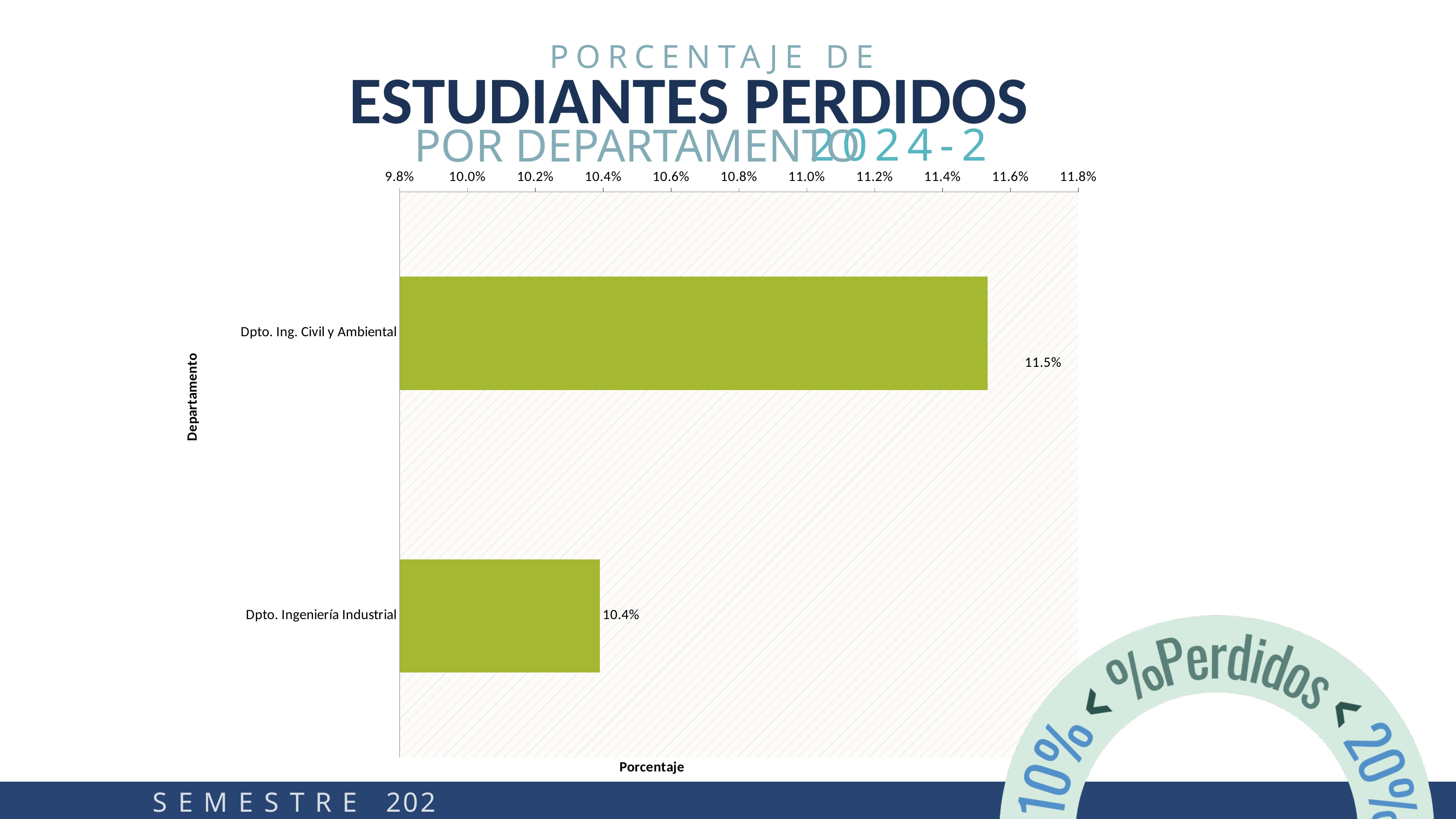
What kind of chart is shown on the slide? Bar chart What is the difference between the values for Dpto. Ing. Civil y Ambiental and Dpto. Ingeniería Industrial? 1.1% Is the value for Dpto. Ingeniería Industrial greater or less than 11.0%? less How many departments are shown in the chart? 2 What is the value for Dpto. Ing. Civil y Ambiental? 11.5% Is the value for Dpto. Ing. Civil y Ambiental greater or less than 11.0%? greater What is the value for Dpto. Ingeniería Industrial? 10.4% What is the label of the horizontal axis? Porcentaje What is the label of the vertical axis? Departamento Which is larger, the value for Dpto. Ing. Civil y Ambiental or the value for Dpto. Ingeniería Industrial? Dpto. Ing. Civil y Ambiental Which department has the lowest percentage of lost students? Dpto. Ingeniería Industrial Which department has the highest percentage of lost students? Dpto. Ing. Civil y Ambiental